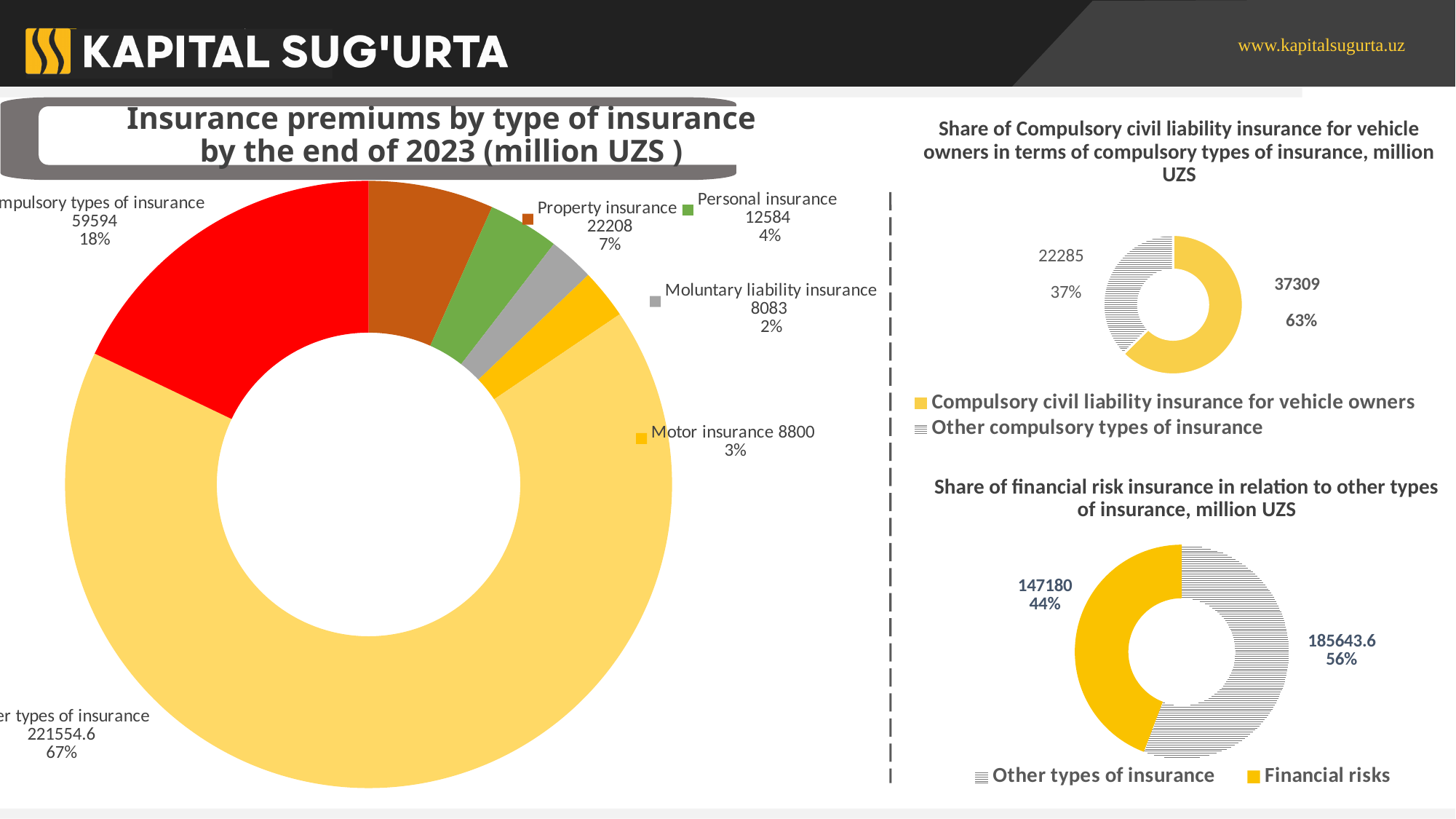
In the chart 'Insurance premiums by type of insurance by the end of 2023', what is the value for Property insurance? 22208 In the chart 'Share of Compulsory civil liability insurance for vehicle owners', what share does Other compulsory types of insurance have? 37% How many entries does the legend of the chart 'Share of financial risk insurance in relation to other types of insurance' list? 2 In the chart 'Share of Compulsory civil liability insurance for vehicle owners', what is the value for Compulsory civil liability insurance for vehicle owners? 37309 How many categories are shown in the chart 'Insurance premiums by type of insurance by the end of 2023'? 6 In the chart 'Insurance premiums by type of insurance by the end of 2023', which category has the smallest value? Moluntary liability insurance In the chart 'Share of financial risk insurance in relation to other types of insurance', what is the value for Financial risks? 147180 In the chart 'Insurance premiums by type of insurance by the end of 2023', which category has the largest value? Other types of insurance In the chart 'Insurance premiums by type of insurance by the end of 2023', what is the difference between Compulsory types of insurance and Property insurance? 37386 What kind of chart is 'Insurance premiums by type of insurance by the end of 2023'? Donut (pie) chart In the chart 'Insurance premiums by type of insurance by the end of 2023', what share does Personal insurance have? 4% In the chart 'Insurance premiums by type of insurance by the end of 2023', which is larger: Motor insurance or Personal insurance? Personal insurance